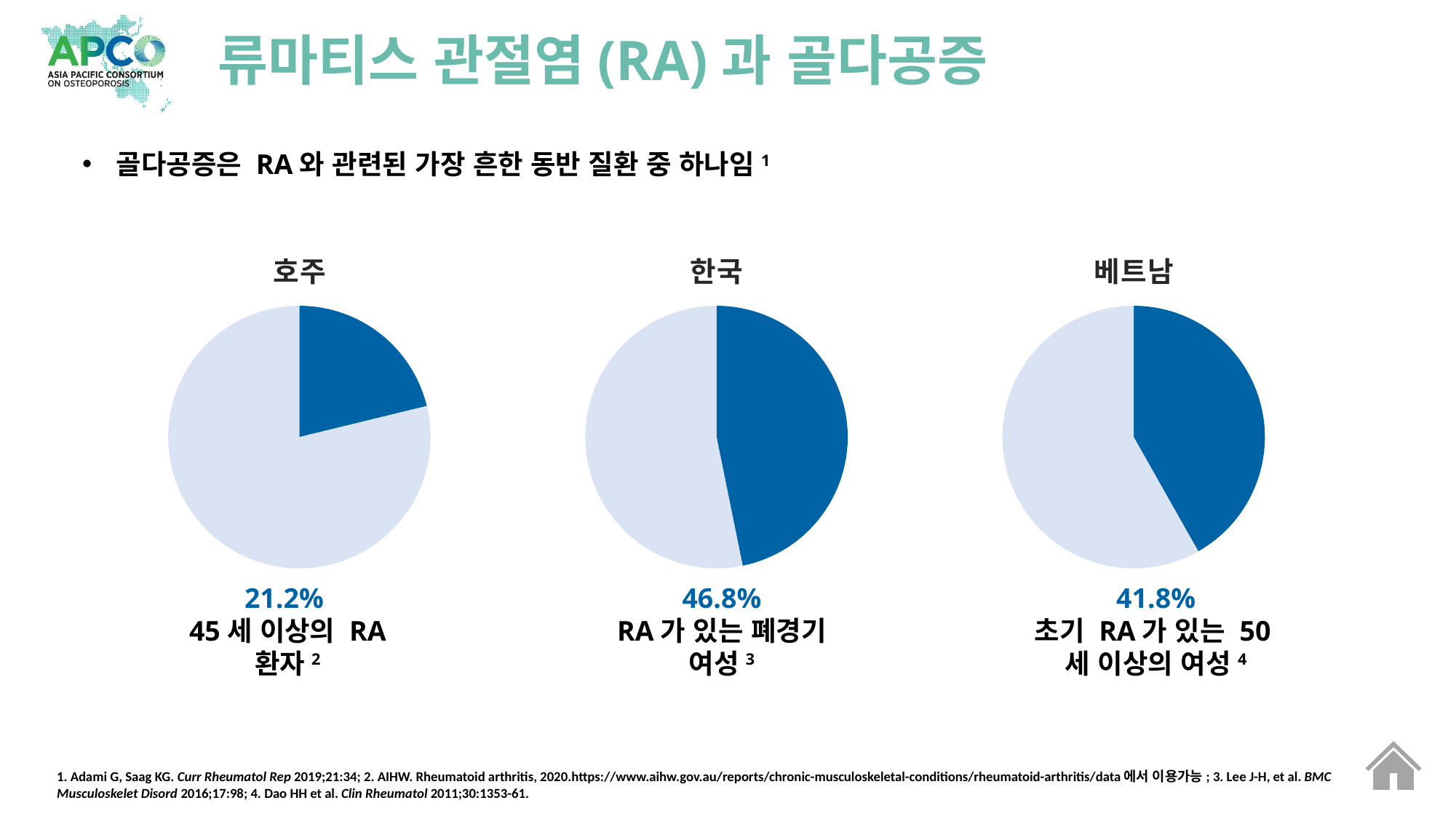
What kind of charts are shown on the slide? Pie charts What is the difference between the percentage shown for 한국 and the percentage shown for 베트남? 5.0% How many pie charts are on the slide? 3 In the 호주 pie chart, what percentage is shown for the dark blue slice? 21.2% Which of the three pie charts shows the lowest percentage? 호주 Which is larger, the percentage shown for 베트남 or the percentage shown for 호주? 베트남 What is the title of the pie chart on the far right? 베트남 How many slices does each pie chart have? 2 In the 한국 pie chart, what percentage is shown for the dark blue slice? 46.8% Which of the three pie charts shows the highest percentage? 한국 What is the difference between the percentage shown for 한국 and the percentage shown for 호주? 25.6% In the 베트남 pie chart, what percentage is shown for the dark blue slice? 41.8%